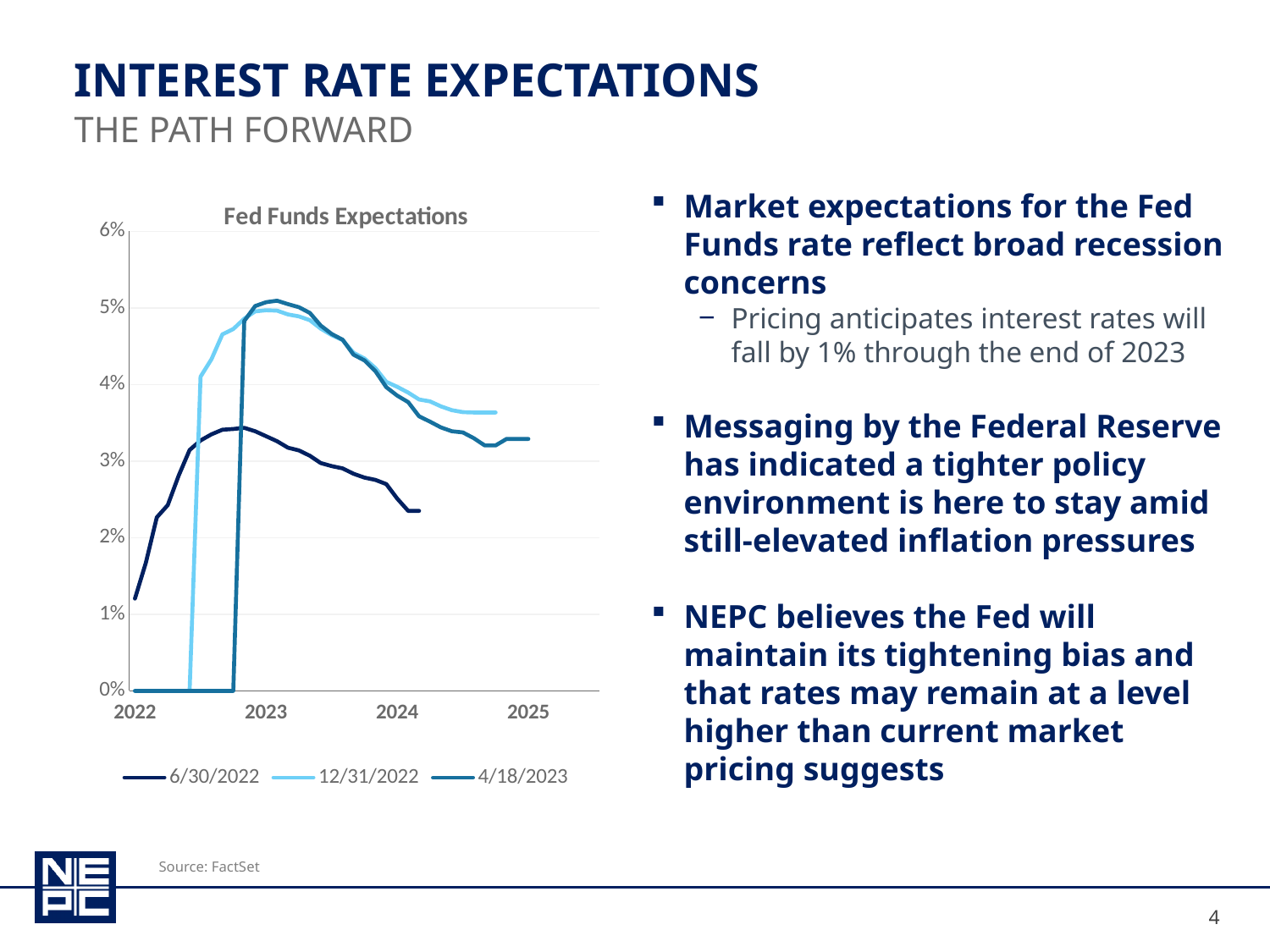
Which series has a higher peak value, 6/30/2022 or 12/31/2022? 12/31/2022 How many series does the legend of the Fed Funds Expectations chart list? 3 Which series reaches the lowest peak value on the chart? 6/30/2022 Is the peak value of the 6/30/2022 series greater or less than 3%? greater Is the value of the 12/31/2022 series at its right-hand end greater or less than 4%? less Is the peak value of the 4/18/2023 series greater or less than 5%? greater What is the title of the chart on the slide? Fed Funds Expectations Does the 4/18/2023 series rise or fall from its peak in 2023 toward 2025? fall What kind of chart is shown on the slide? line chart What are the three series listed in the chart's legend? 6/30/2022, 12/31/2022, 4/18/2023